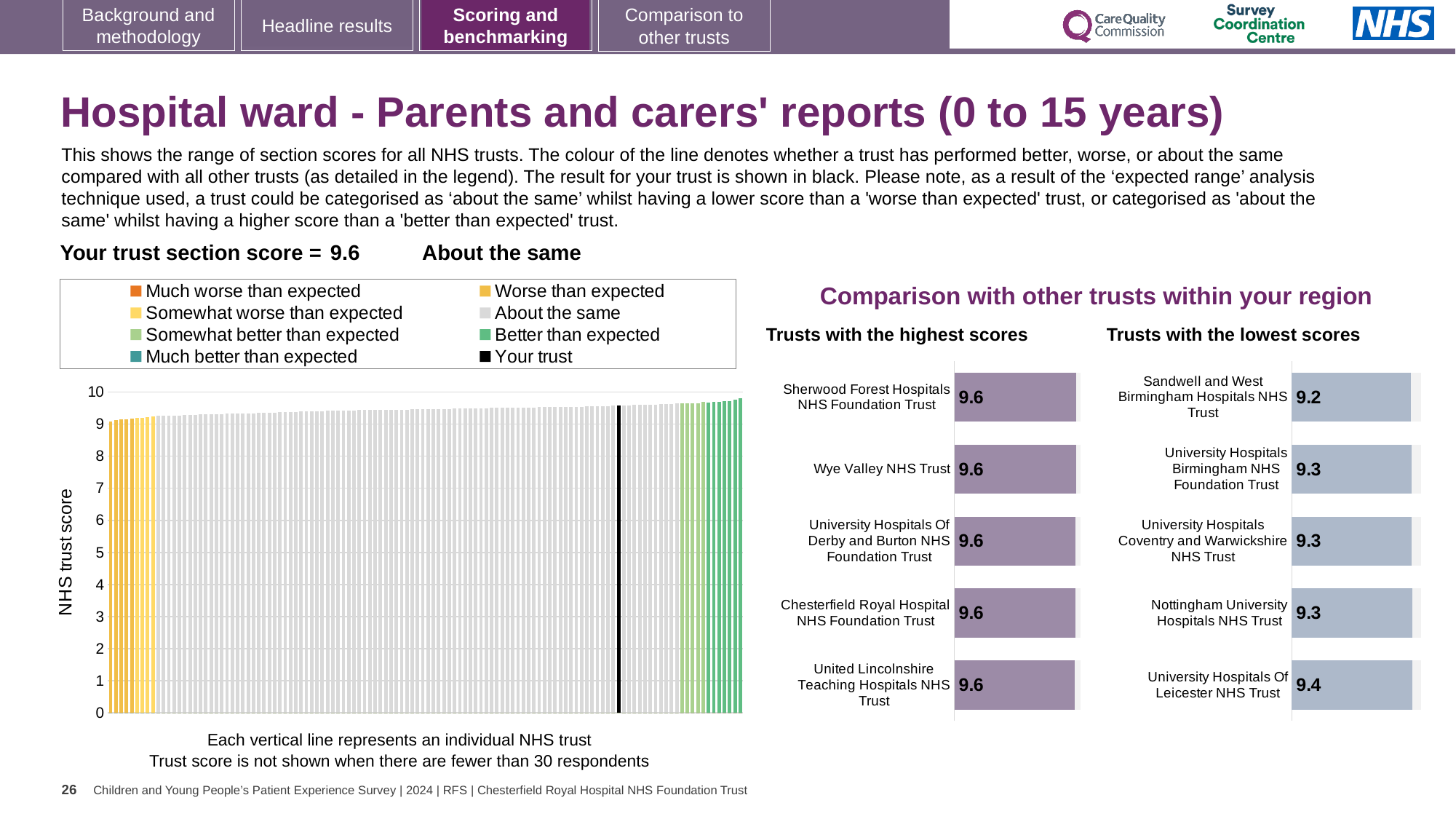
In the large chart on the left, what is the label on the vertical axis? NHS trust score In the 'Trusts with the lowest scores' chart, which has the larger score: Sandwell and West Birmingham Hospitals NHS Trust or Nottingham University Hospitals NHS Trust? Nottingham University Hospitals NHS Trust In the 'Trusts with the lowest scores' chart, what is the score for Sandwell and West Birmingham Hospitals NHS Trust? 9.2 In the 'Trusts with the lowest scores' chart, which trust has the lowest score? Sandwell and West Birmingham Hospitals NHS Trust In the 'Trusts with the highest scores' chart, what is the score for Wye Valley NHS Trust? 9.6 In the large chart on the left, is the value of the lowest bar greater or less than 8? greater How many entries does the legend above the large chart on the left list? 8 In the 'Trusts with the lowest scores' chart, what is the score for University Hospitals Of Leicester NHS Trust? 9.4 How many trusts are shown in the 'Trusts with the highest scores' chart? 5 In the 'Trusts with the lowest scores' chart, which trust has the highest score? University Hospitals Of Leicester NHS Trust What kind of chart is the large chart on the left showing all NHS trusts? Bar chart In the 'Trusts with the lowest scores' chart, what is the difference between the scores of University Hospitals Of Leicester NHS Trust and Sandwell and West Birmingham Hospitals NHS Trust? 0.2